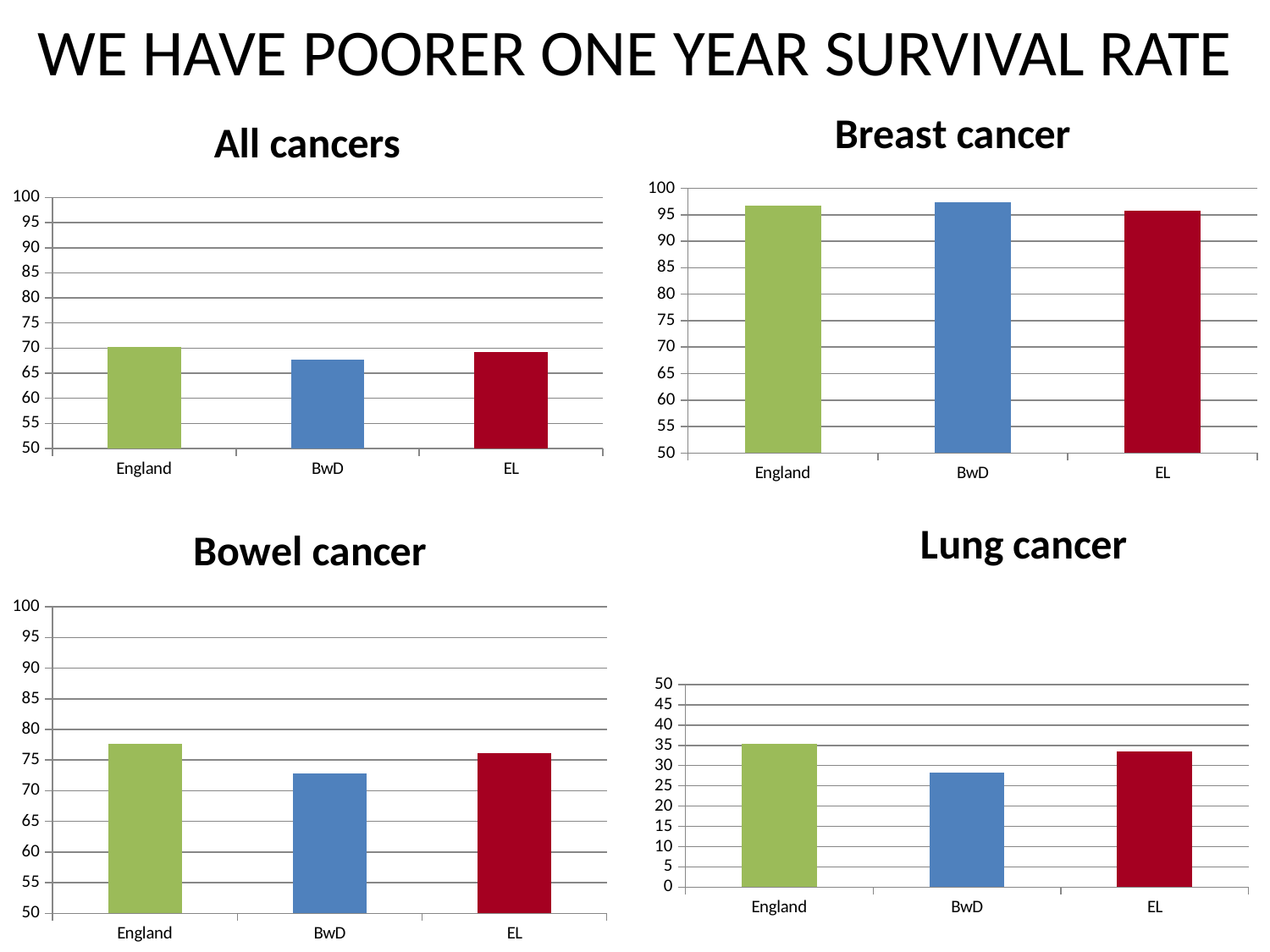
On the "Bowel cancer" chart, is the value for BwD greater or less than 75? less What kind of chart is the "All cancers" chart? bar chart On the "Lung cancer" chart, is the value for BwD greater or less than 30? less On the "All cancers" chart, is the value for BwD greater or less than 70? less On the "Lung cancer" chart, which category has the lowest value? BwD On the "Bowel cancer" chart, which is larger, the value for England or the value for BwD? England On the "All cancers" chart, which category has the lowest value? BwD On the "Lung cancer" chart, which is larger, the value for EL or the value for BwD? EL On the "Bowel cancer" chart, which category has the lowest value? BwD How many categories are shown on the "Lung cancer" chart? 3